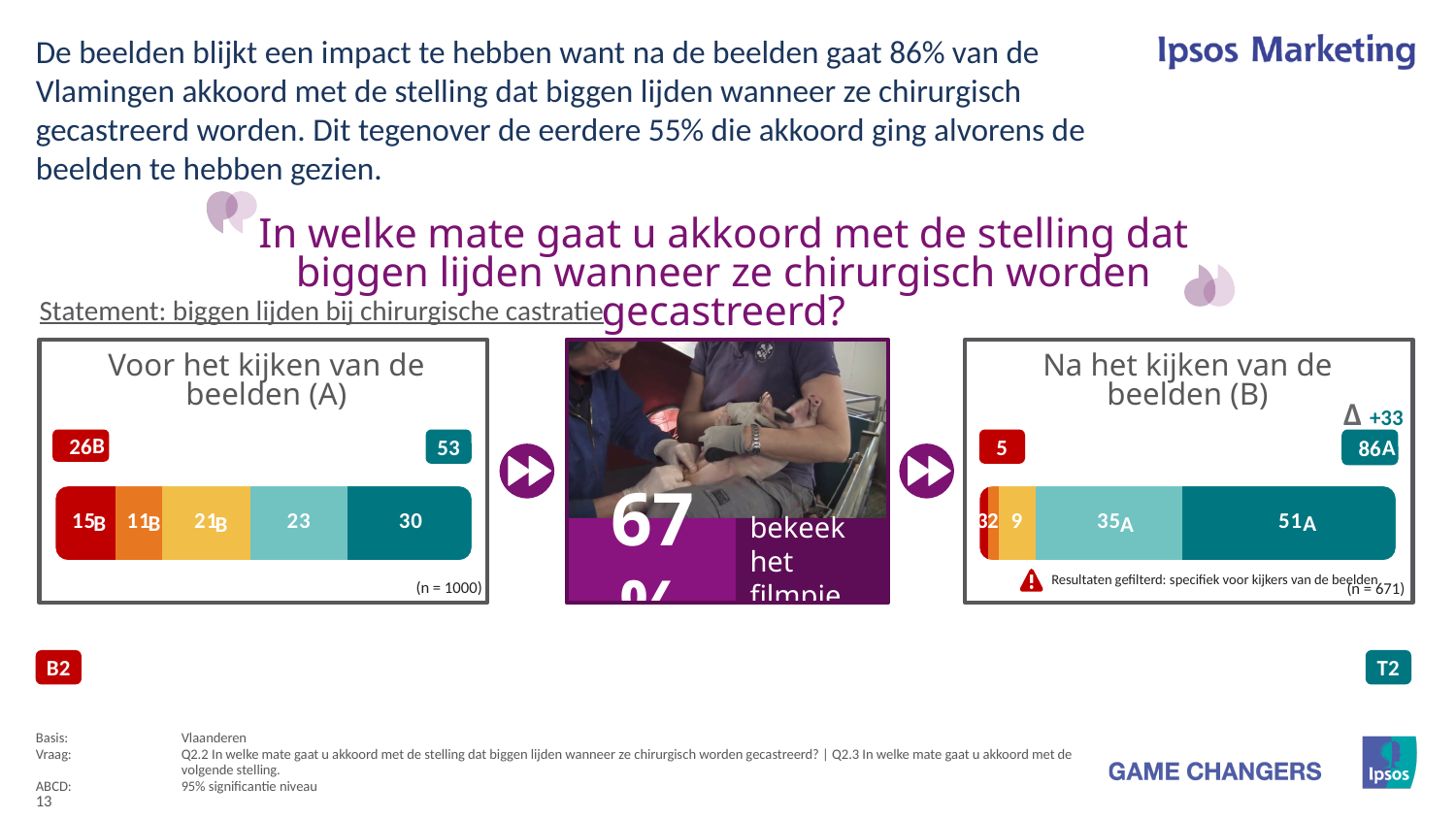
In the 'Voor het kijken van de beelden (A)' chart, what is the value of the dark teal segment at the right end of the bar? 30 In the 'Voor het kijken van de beelden (A)' chart, what is the value of the yellow segment? 21 What is the difference between the dark teal segment in the 'Na het kijken van de beelden (B)' chart (51) and the dark teal segment in the 'Voor het kijken van de beelden (A)' chart (30)? 21 In the 'Na het kijken van de beelden (B)' chart, what is the value of the dark teal segment at the right end of the bar? 51 What is the sample size (n) shown for the 'Na het kijken van de beelden (B)' chart? n = 671 In the 'Voor het kijken van de beelden (A)' chart, which segment has the largest value? The dark teal segment (30) In the 'Voor het kijken van de beelden (A)' chart, what is the value of the light teal segment? 23 In the 'Voor het kijken van de beelden (A)' chart, what is the value of the dark red segment at the left end of the bar? 15 In the 'Na het kijken van de beelden (B)' chart, what is the value of the light teal segment? 35 In the 'Voor het kijken van de beelden (A)' chart, which segment has the smallest value? The orange segment (11) Which is larger: the light teal segment in the 'Voor het kijken van de beelden (A)' chart or the light teal segment in the 'Na het kijken van de beelden (B)' chart? Na het kijken van de beelden (B) What type of chart is used for 'Voor het kijken van de beelden (A)'? Stacked bar chart